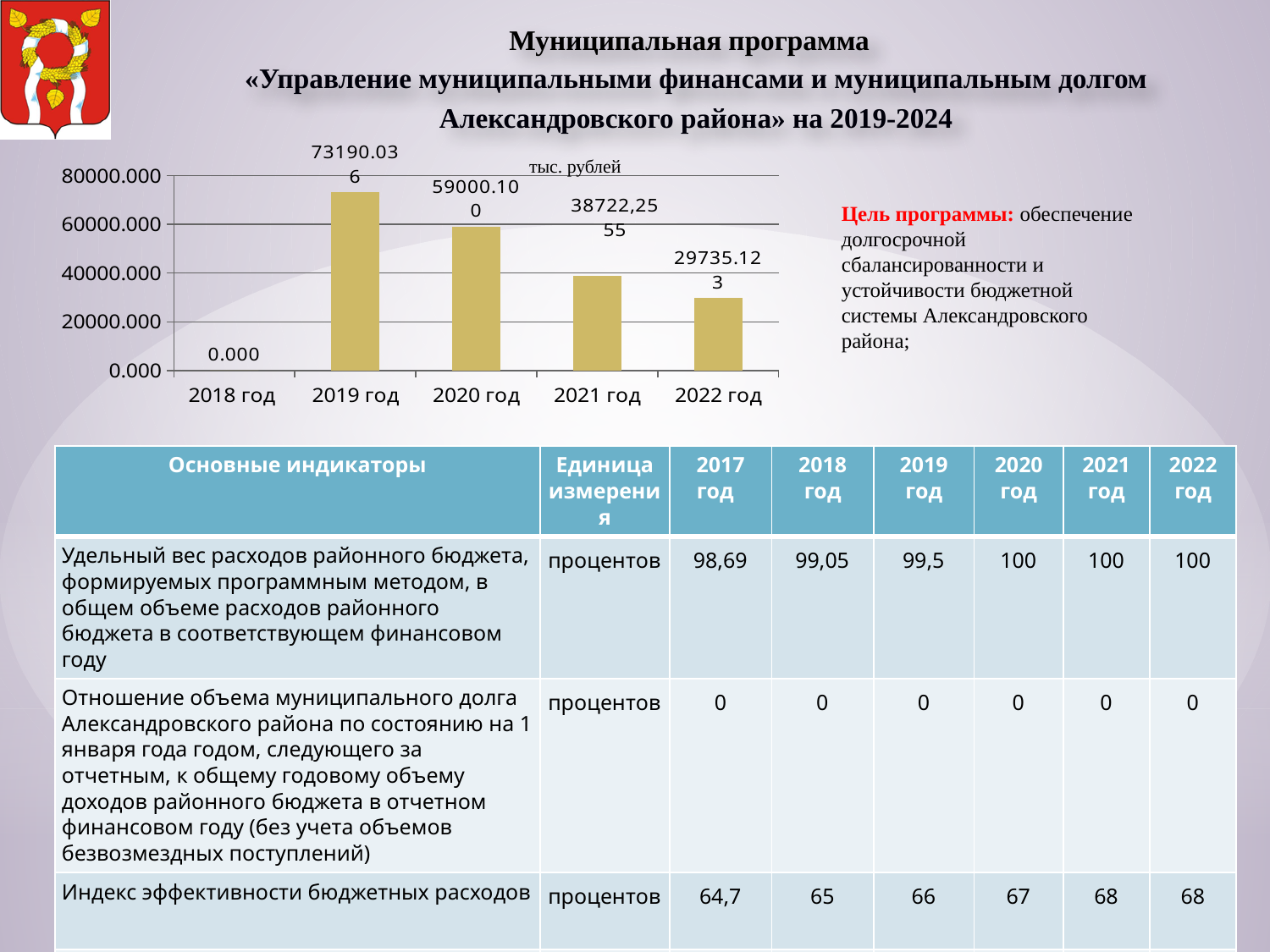
Is the value for 2021 год greater or less than 40000.000? less Is the value for 2019 год greater or less than 60000.000? greater What kind of chart is shown on the slide? bar chart Which year has the highest bar in the chart? 2019 год Which is larger, the value for 2020 год or the value for 2021 год? 2020 год What is the value shown for 2018 год in the chart? 0.000 From 2019 год to 2022 год, do the values in the chart rise or fall? fall Is the value for 2020 год greater or less than 60000.000? less How many year categories are shown on the x axis of the chart? 5 Which year has the lowest value in the chart? 2018 год What unit label is printed above the chart? тыс. рублей